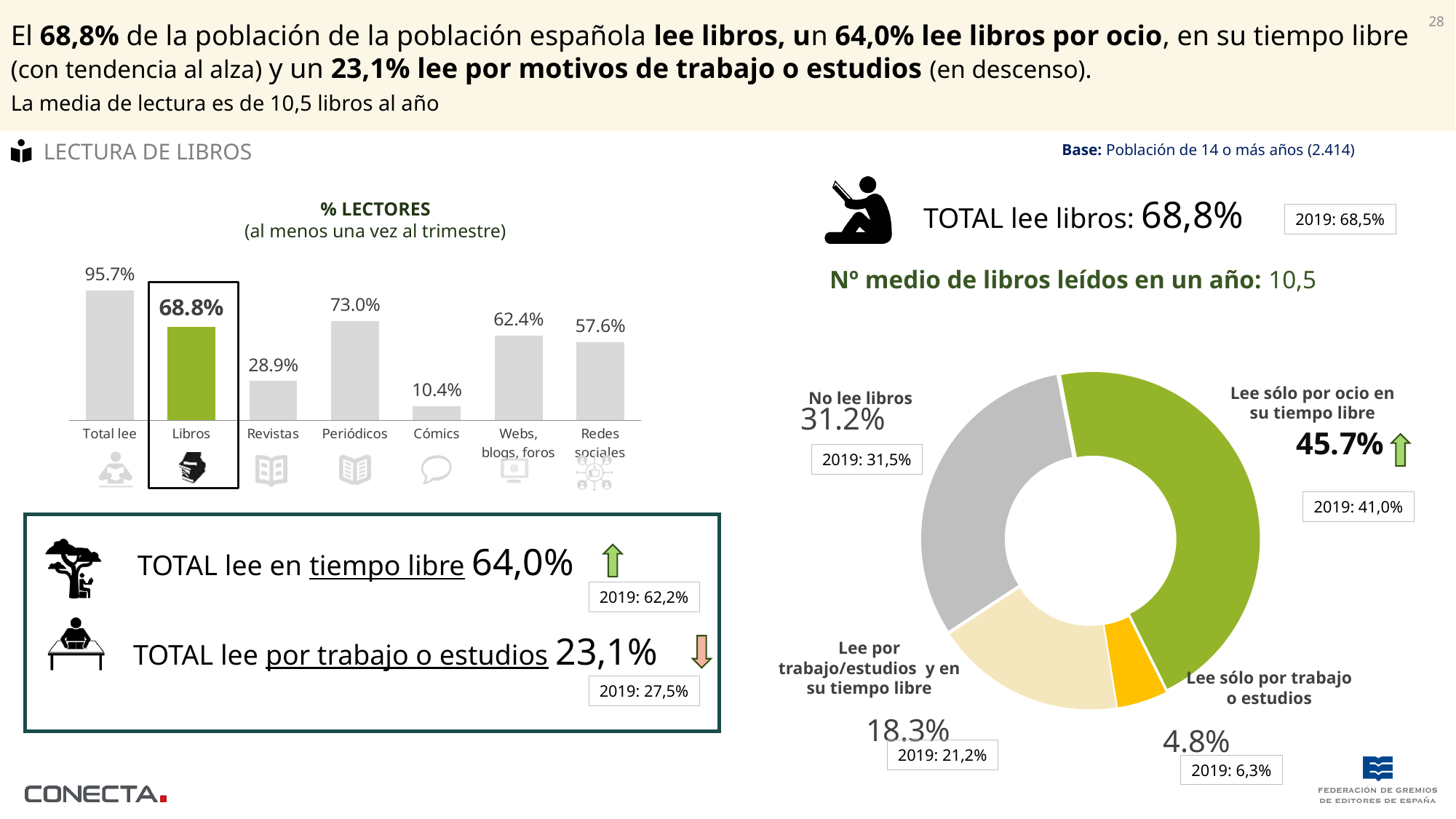
In the bar chart '% LECTORES', which category has the highest value? Total lee In the bar chart '% LECTORES', what is the value for Periódicos? 73.0% In the donut chart on the right, what share corresponds to 'Lee sólo por ocio en su tiempo libre'? 45.7% In the bar chart '% LECTORES', which bar is highlighted in green? Libros In the donut chart on the right, what is the value for 'No lee libros'? 31.2% In the bar chart '% LECTORES', which is larger, the value for Webs, blogs, foros or the value for Redes sociales? Webs, blogs, foros In the bar chart '% LECTORES', what is the value for Redes sociales? 57.6% What kind of chart is the '% LECTORES' chart on the left of the slide? Bar chart In the bar chart '% LECTORES', what is the difference between the values for Libros and Revistas? 39.9% In the bar chart '% LECTORES', which category has the lowest value? Cómics How many categories are shown in the bar chart '% LECTORES'? 7 In the donut chart on the right, which segment is the smallest? Lee sólo por trabajo o estudios